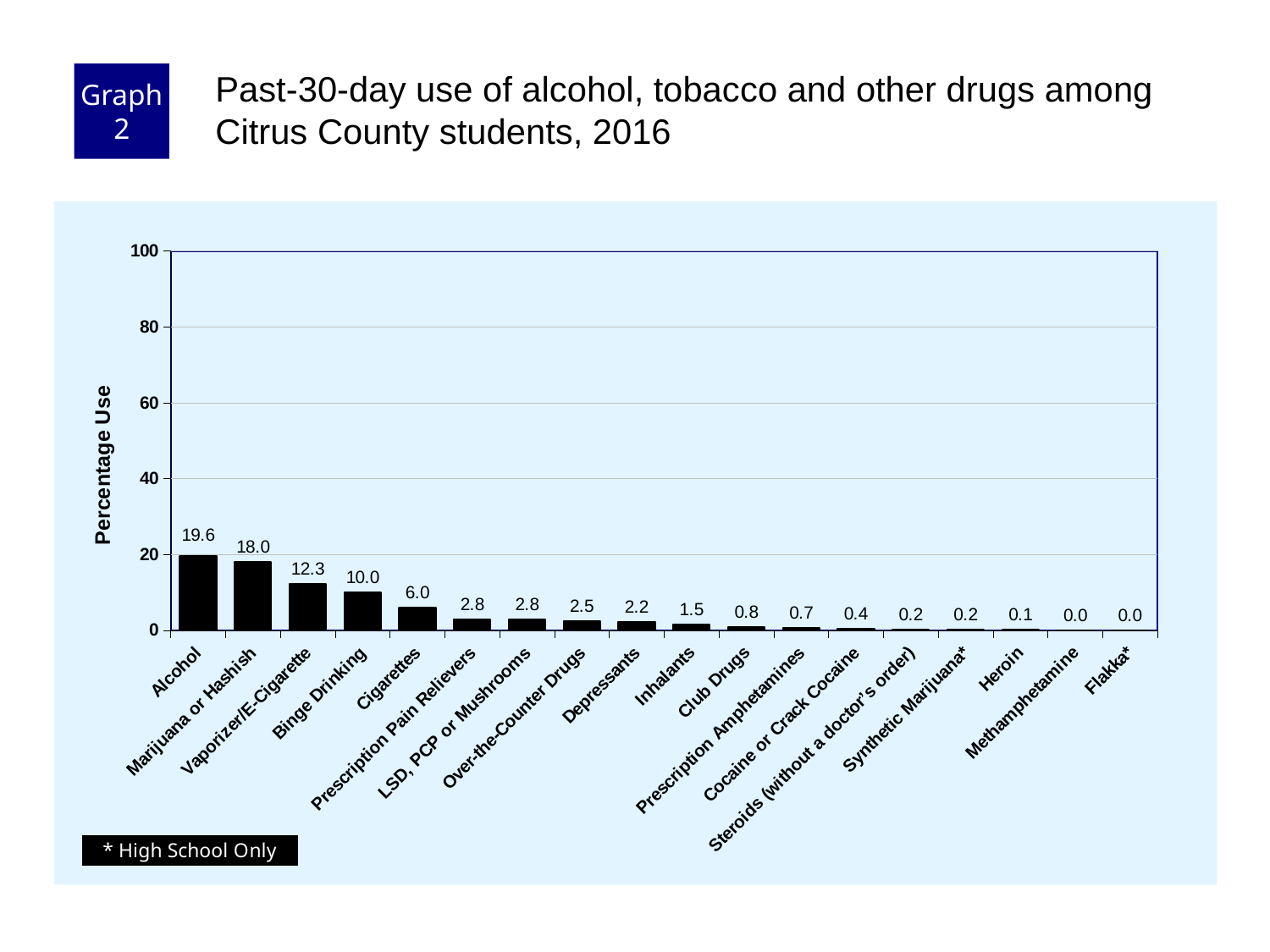
What is the percentage use for Cigarettes? 6.0 What is the percentage use for Heroin? 0.1 What is the percentage use for Inhalants? 1.5 Which category has the highest percentage use? Alcohol What kind of chart is shown on the slide? Bar chart What is the percentage use for Vaporizer/E-Cigarette? 12.3 What is the label of the y axis? Percentage Use What is the difference in percentage use between Alcohol and Marijuana or Hashish? 1.6 How many categories are shown on the x axis? 18 What is the percentage use for Alcohol? 19.6 Which has a higher percentage use, Depressants or Over-the-Counter Drugs? Over-the-Counter Drugs What is the difference in percentage use between Binge Drinking and Cigarettes? 4.0